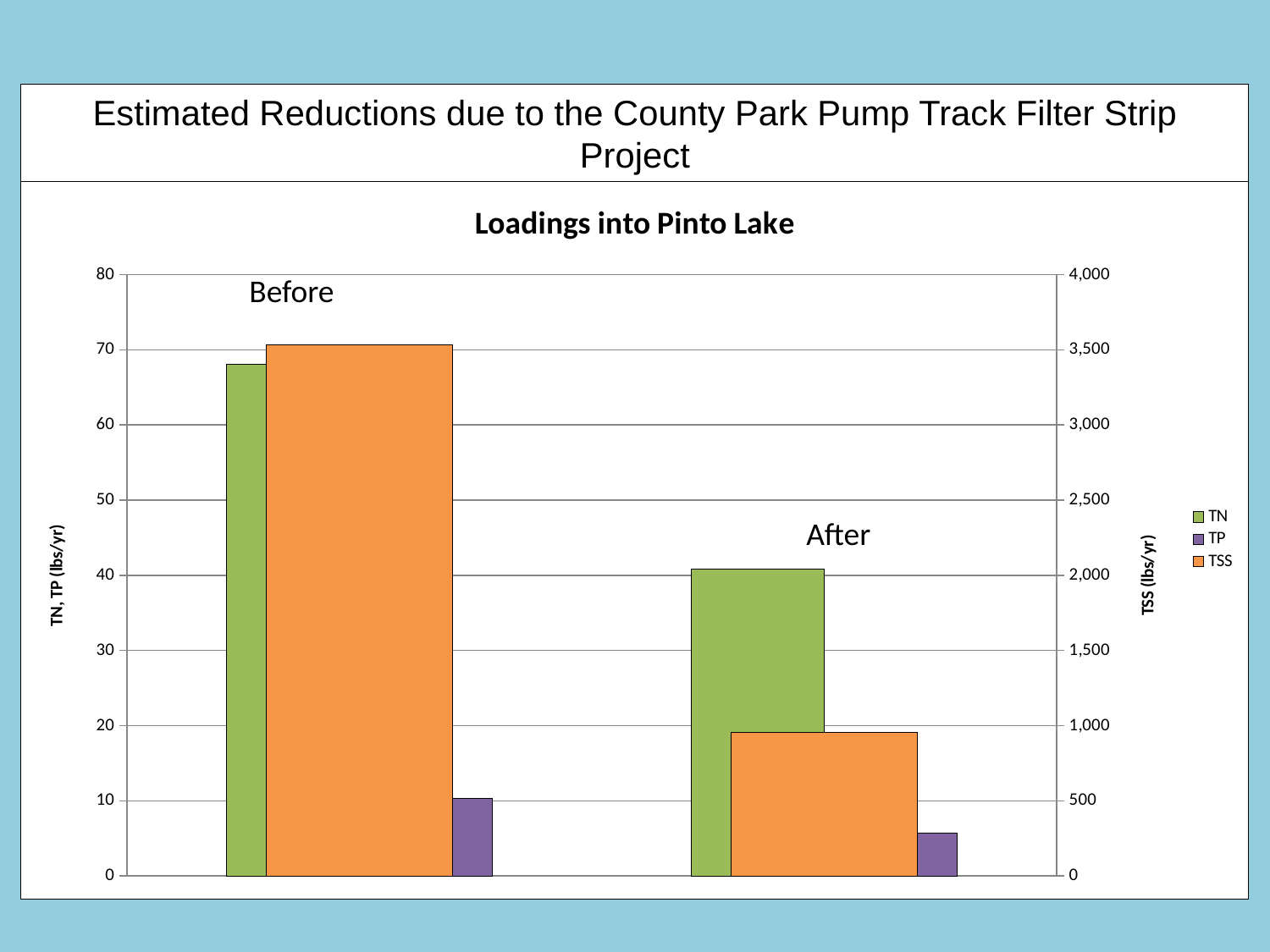
What kind of chart is shown on the slide? bar chart How many series does the legend list? 3 What is the title of the chart? Loadings into Pinto Lake Is the TSS value for Before greater or less than 3,000 on the right axis? greater Is the TN value for After greater or less than 50 on the left axis? less Is the TN value for Before greater or less than 60 on the left axis? greater How many categories (groups of bars) are shown on the x axis? 2 What is the label of the right-hand vertical axis? TSS (lbs/yr) Which has the larger TN value, Before or After? Before Do the TSS values rise or fall from Before to After? fall